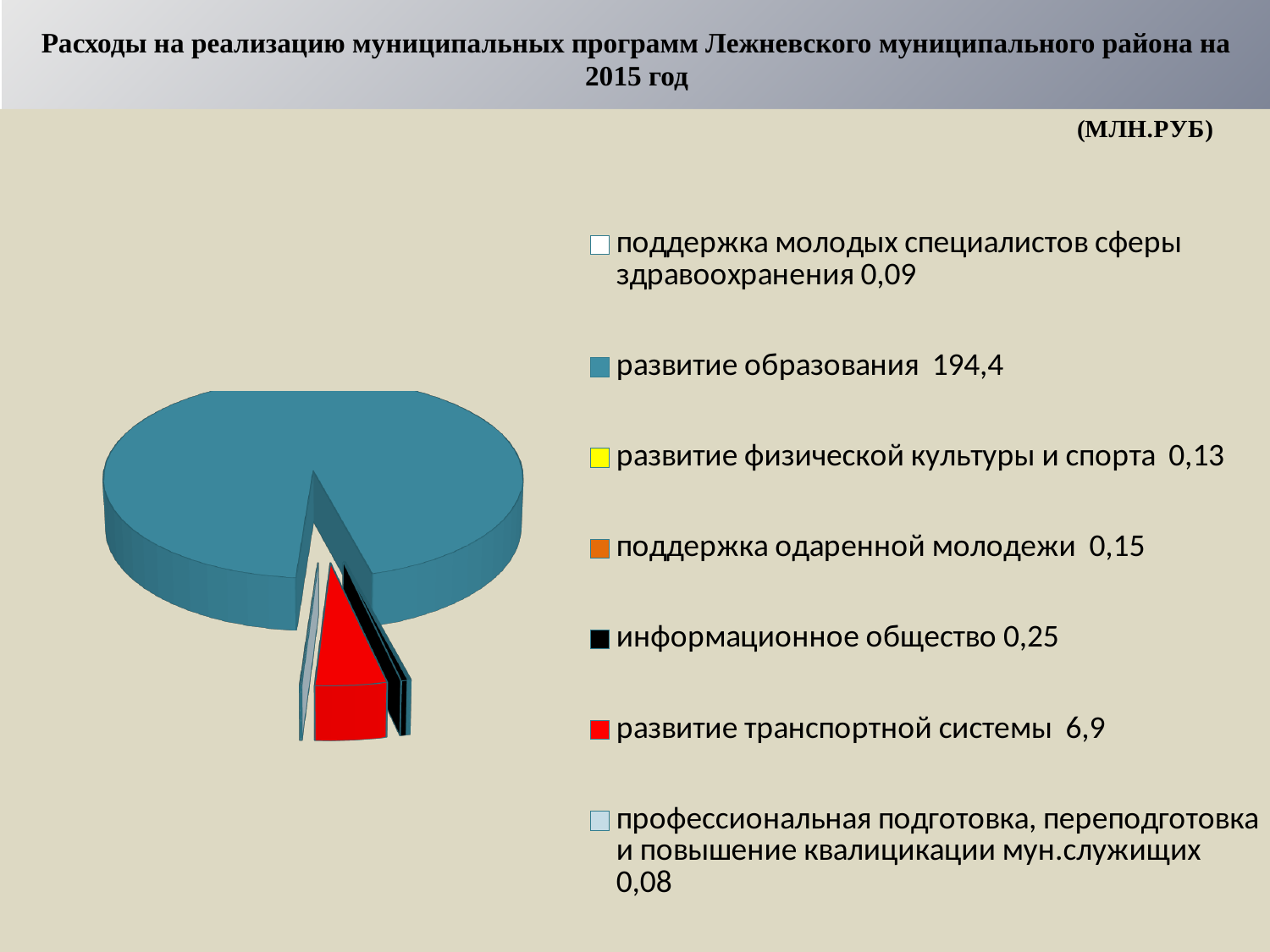
What unit is stated for the values on the slide? МЛН.РУБ What type of chart is shown on the slide? pie chart Which is larger: the value for информационное общество or the value for развитие физической культуры и спорта? информационное общество What is the value for развитие образования? 194,4 What is the difference between the values for развитие образования and развитие транспортной системы? 187,5 What is the value for поддержка одаренной молодежи? 0,15 Which category has the highest value? развитие образования What is the value for информационное общество? 0,25 What colour is the slice for развитие транспортной системы? red What is the value for развитие транспортной системы? 6,9 Which category has the lowest value? профессиональная подготовка, переподготовка и повышение квалицикации мун.служищих How many categories does the pie chart's legend list? 7